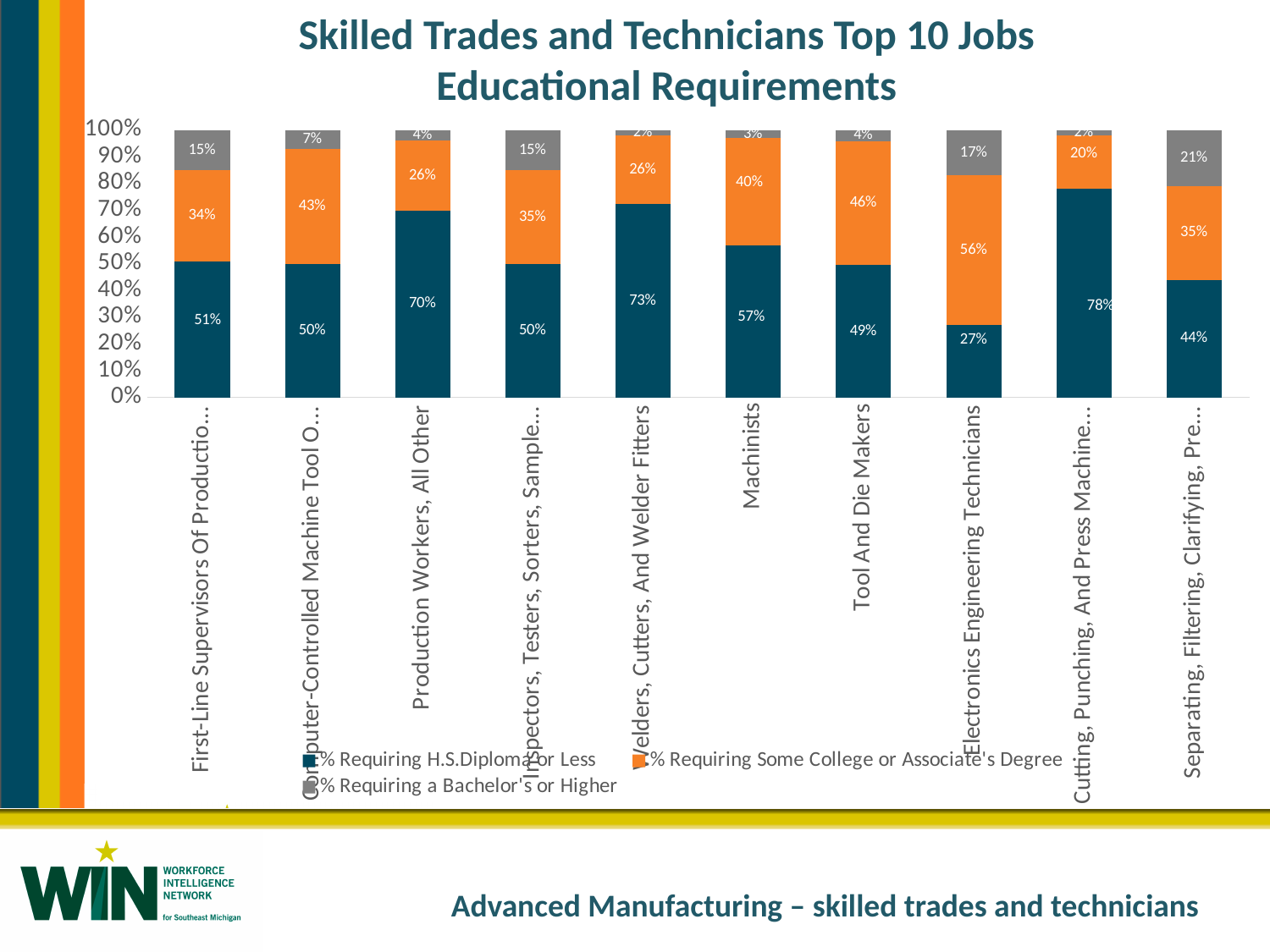
What is the difference between the Some College or Associate's Degree share for Tool And Die Makers and for Machinists? 6 percentage points What is the title of the chart? Skilled Trades and Technicians Top 10 Jobs Educational Requirements Which job has the lowest share requiring a H.S. Diploma or Less? Electronics Engineering Technicians What kind of chart is shown on the slide? Stacked bar chart What percentage of Electronics Engineering Technicians jobs require Some College or Associate's Degree? 56% How many series does the legend list? 3 Is the H.S. Diploma or Less share for Tool And Die Makers greater or less than 50%? less What percentage of Machinists jobs require a H.S. Diploma or Less? 57% Which has a larger share requiring a H.S. Diploma or Less: Welders, Cutters, And Welder Fitters or Production Workers, All Other? Welders, Cutters, And Welder Fitters Which job has the highest share requiring Some College or Associate's Degree? Electronics Engineering Technicians What percentage of Tool And Die Makers jobs require a Bachelor's or Higher? 4% How many jobs are shown on the x axis of the chart? 10